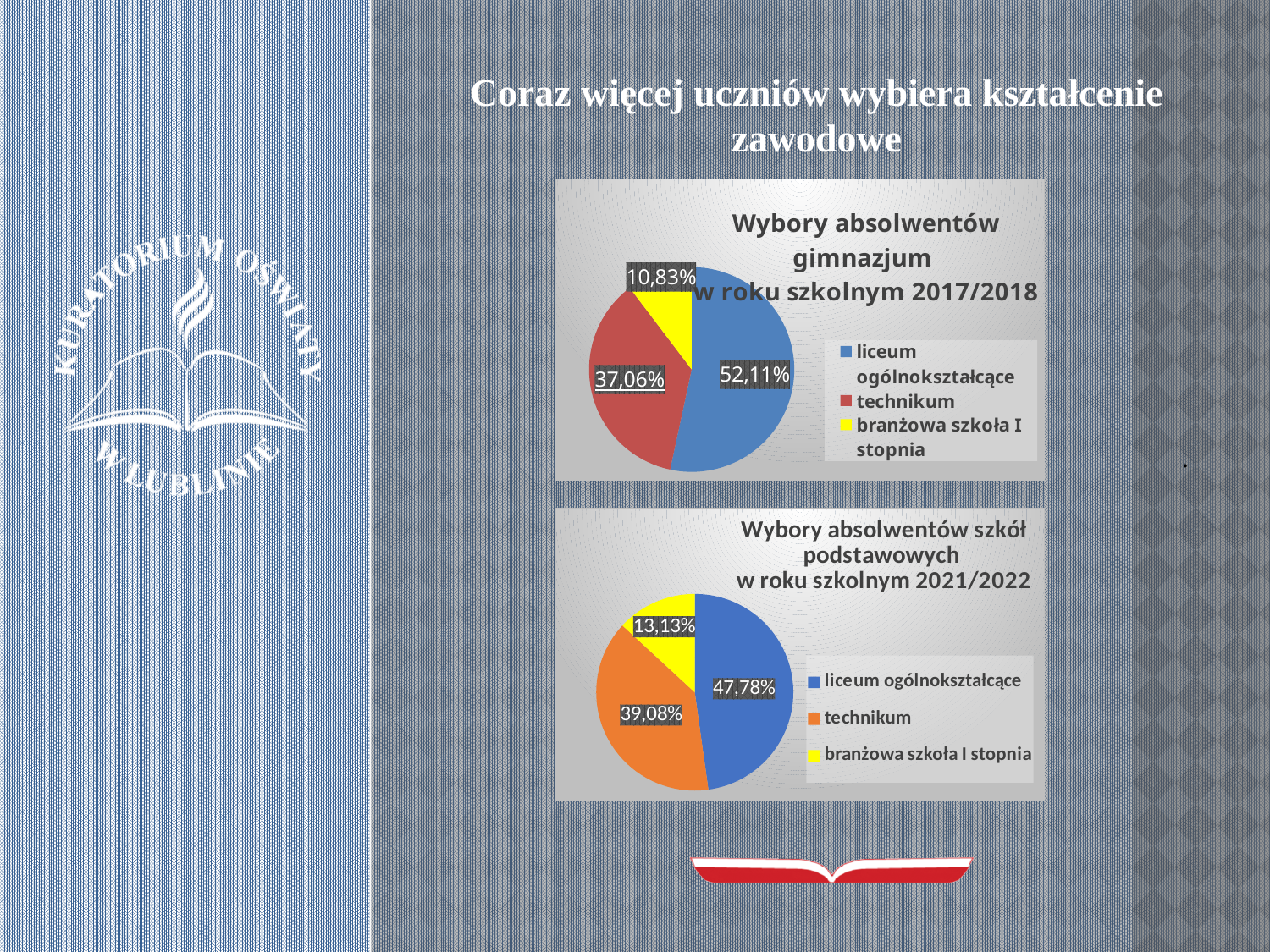
In the top chart (2017/2018), what colour is the slice for technikum? red In the bottom chart (2021/2022), what share is shown for liceum ogólnokształcące? 47,78% What kind of chart is the top chart, 'Wybory absolwentów gimnazjum w roku szkolnym 2017/2018'? pie chart In the top chart (2017/2018), what share is shown for technikum? 37,06% In the bottom chart (2021/2022), what share is shown for branżowa szkoła I stopnia? 13,13% In the top chart (2017/2018), which category has the smallest slice? branżowa szkoła I stopnia In the top chart (2017/2018), what share is shown for liceum ogólnokształcące? 52,11% In the top chart (2017/2018), what share is shown for branżowa szkoła I stopnia? 10,83% How many categories does the legend of the bottom chart (2021/2022) list? 3 In the bottom chart (2021/2022), what share is shown for technikum? 39,08% In the top chart (2017/2018), which category has the largest slice? liceum ogólnokształcące In the bottom chart (2021/2022), which is larger: the slice for liceum ogólnokształcące or the slice for technikum? liceum ogólnokształcące